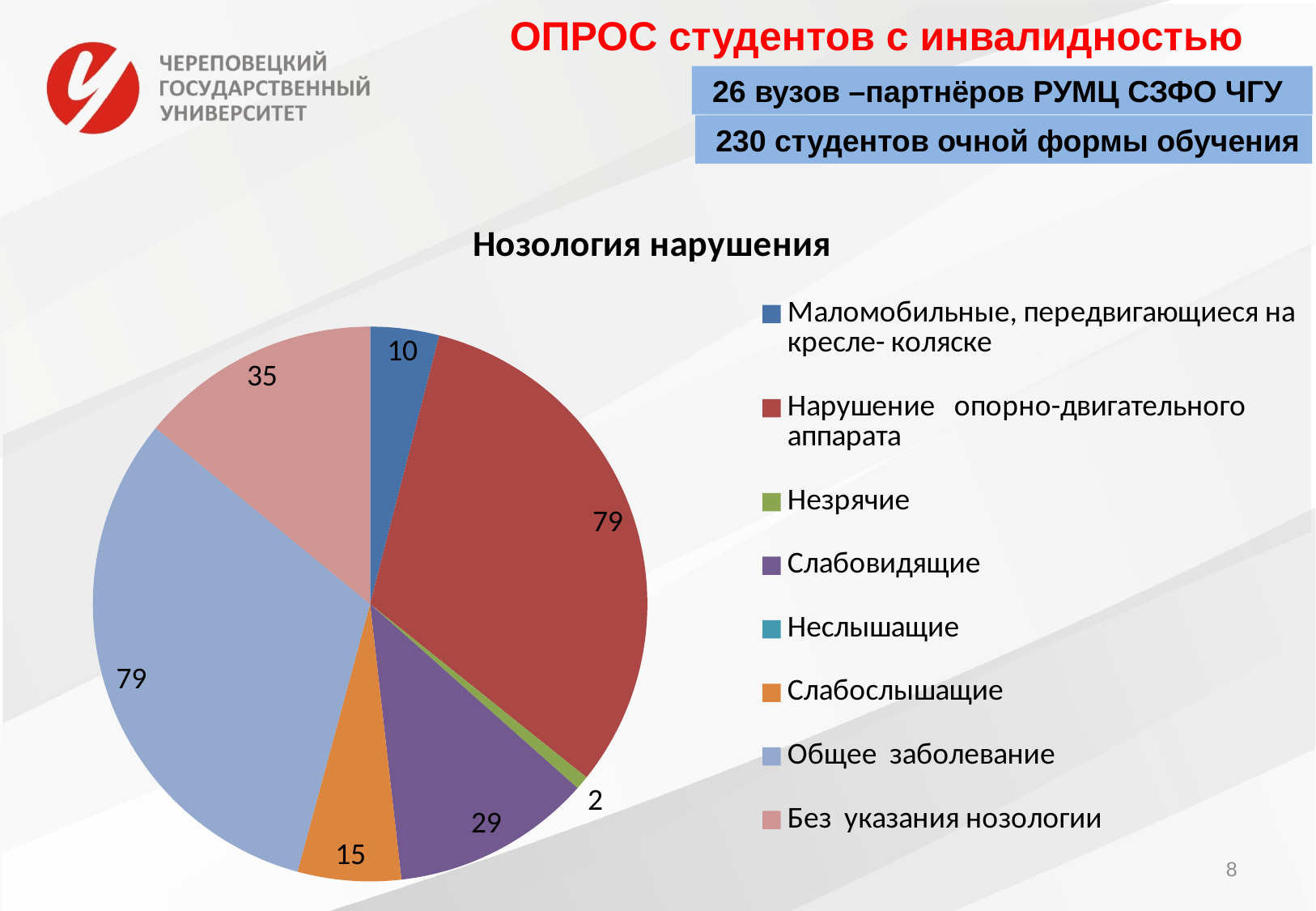
What value is shown for "Общее заболевание"? 79 What value is shown for "Слабовидящие"? 29 What type of chart is shown on the slide? Pie chart What value is shown for "Нарушение опорно-двигательного аппарата"? 79 What value is shown for "Без указания нозологии"? 35 How many entries does the chart legend list? 8 What is the difference between the values for "Без указания нозологии" and "Слабовидящие"? 6 What value is shown for the "Незрячие" slice? 2 Which is larger: the value for "Слабовидящие" or for "Без указания нозологии"? Без указания нозологии What value is shown for the slice "Маломобильные, передвигающиеся на кресле- коляске"? 10 What is the difference between the values for "Слабовидящие" and "Слабослышащие"? 14 What value is shown for "Слабослышащие"? 15